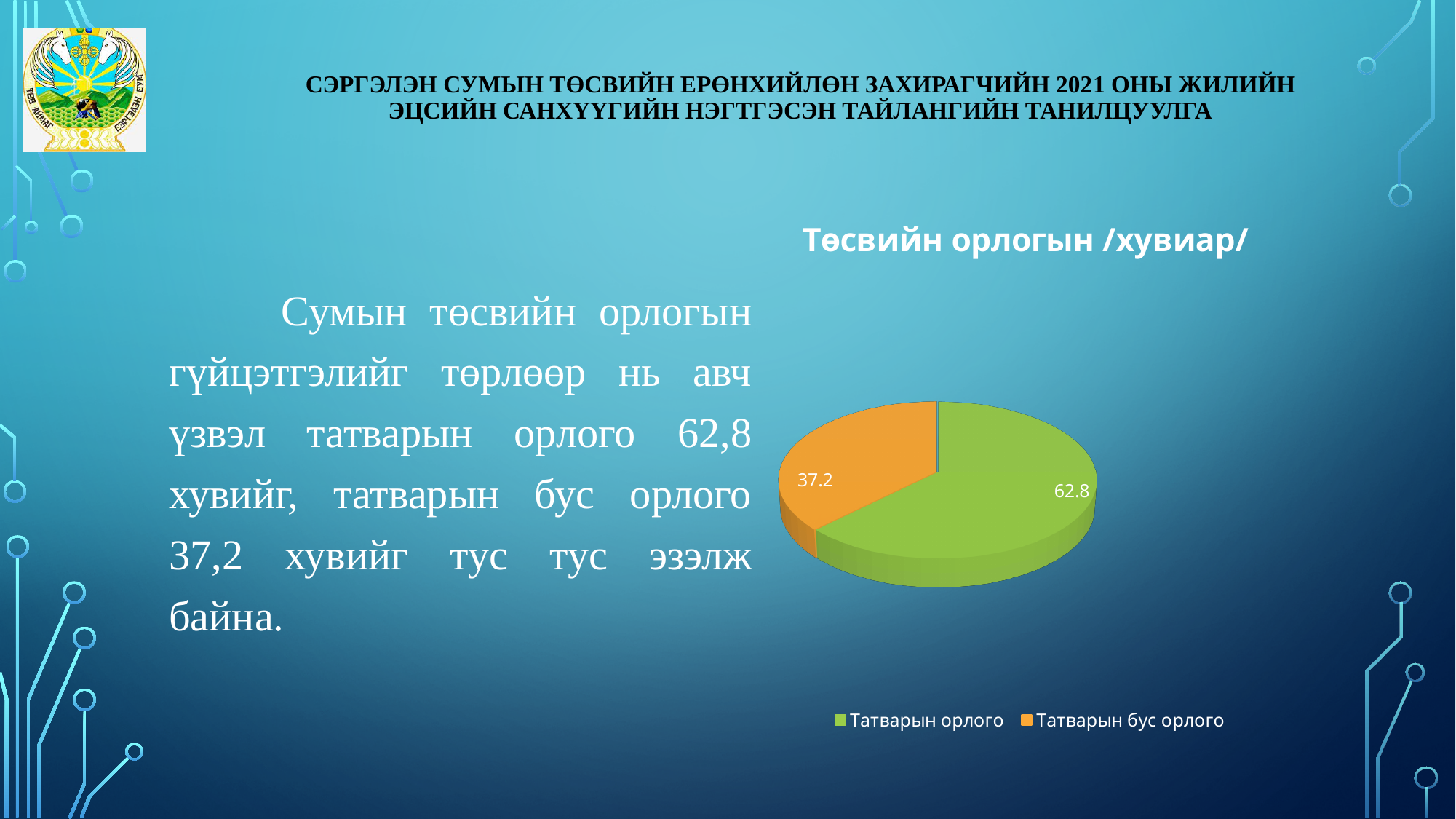
What is the value shown for Татварын орлого? 62.8 What is the value shown for Татварын бус орлого? 37.2 How many entries does the legend list? 2 Which is larger, Татварын орлого or Татварын бус орлого? Татварын орлого Which category has the largest slice of the pie? Татварын орлого What share of the pie does Татварын орлого represent? 62.8% What colour is the slice for Татварын бус орлого? Orange What is the title of the chart? Төсвийн орлогын /хувиар/ Which category has the smallest slice of the pie? Татварын бус орлого What kind of chart is shown on the slide? Pie chart What is the difference between the values for Татварын орлого and Татварын бус орлого? 25.6 How many slices does the pie chart have? 2